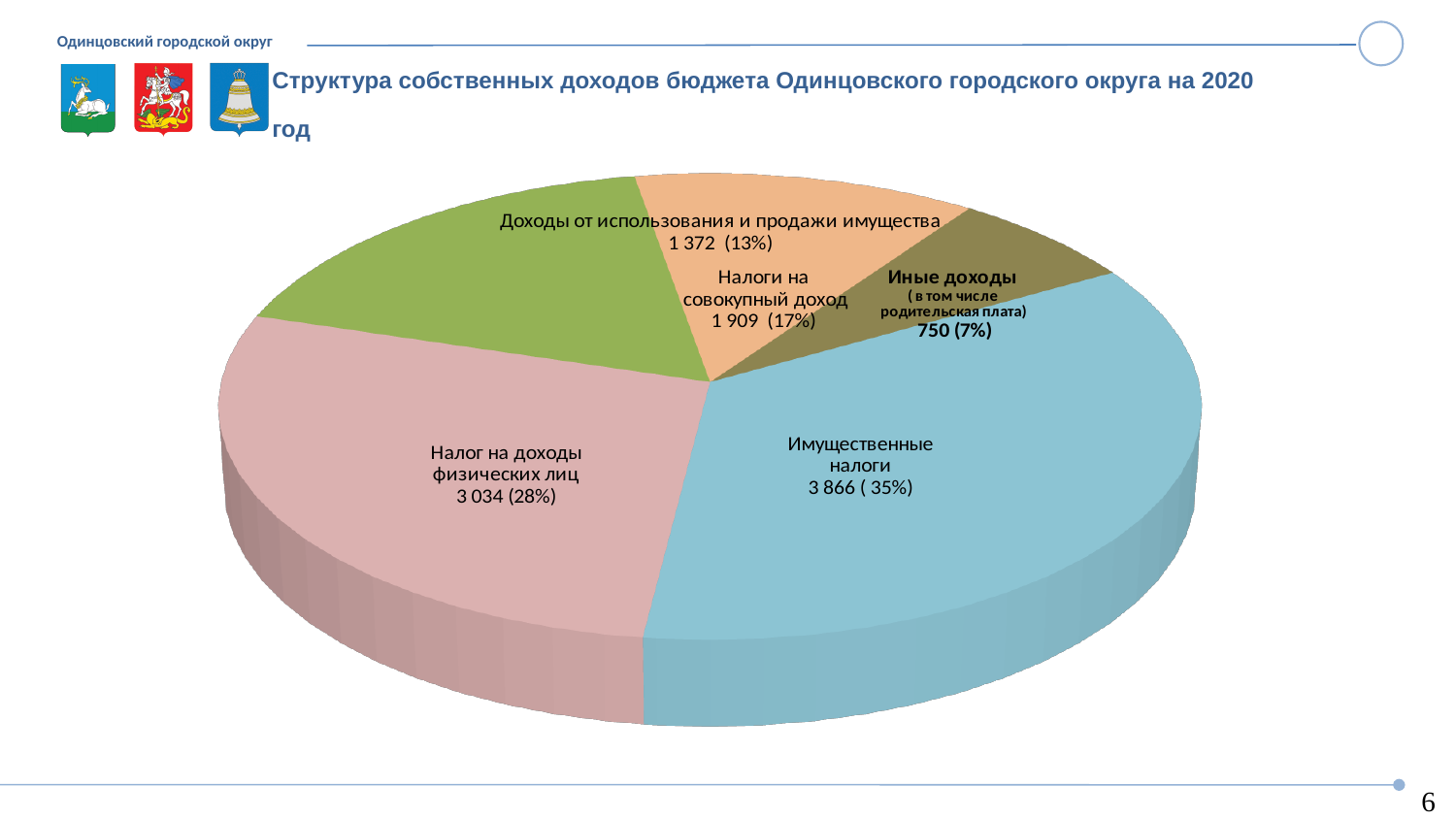
What is the value shown for Налог на доходы физических лиц? 3 034 Which is larger, the value for Налоги на совокупный доход or the value for Доходы от использования и продажи имущества? Налоги на совокупный доход What is the title of the chart on the slide? Структура собственных доходов бюджета Одинцовского городского округа на 2020 год What is the value shown for Имущественные налоги? 3 866 Which category has the smallest slice of the pie? Иные доходы (в том числе родительская плата) What is the difference between the values for Имущественные налоги and Налог на доходы физических лиц? 832 How many slices does the pie chart have? 5 What share of the pie does Доходы от использования и продажи имущества represent? 13% What is the value shown for Налоги на совокупный доход? 1 909 What is the value shown for Иные доходы (в том числе родительская плата)? 750 What kind of chart is shown on the slide? pie chart Which category has the largest slice of the pie? Имущественные налоги